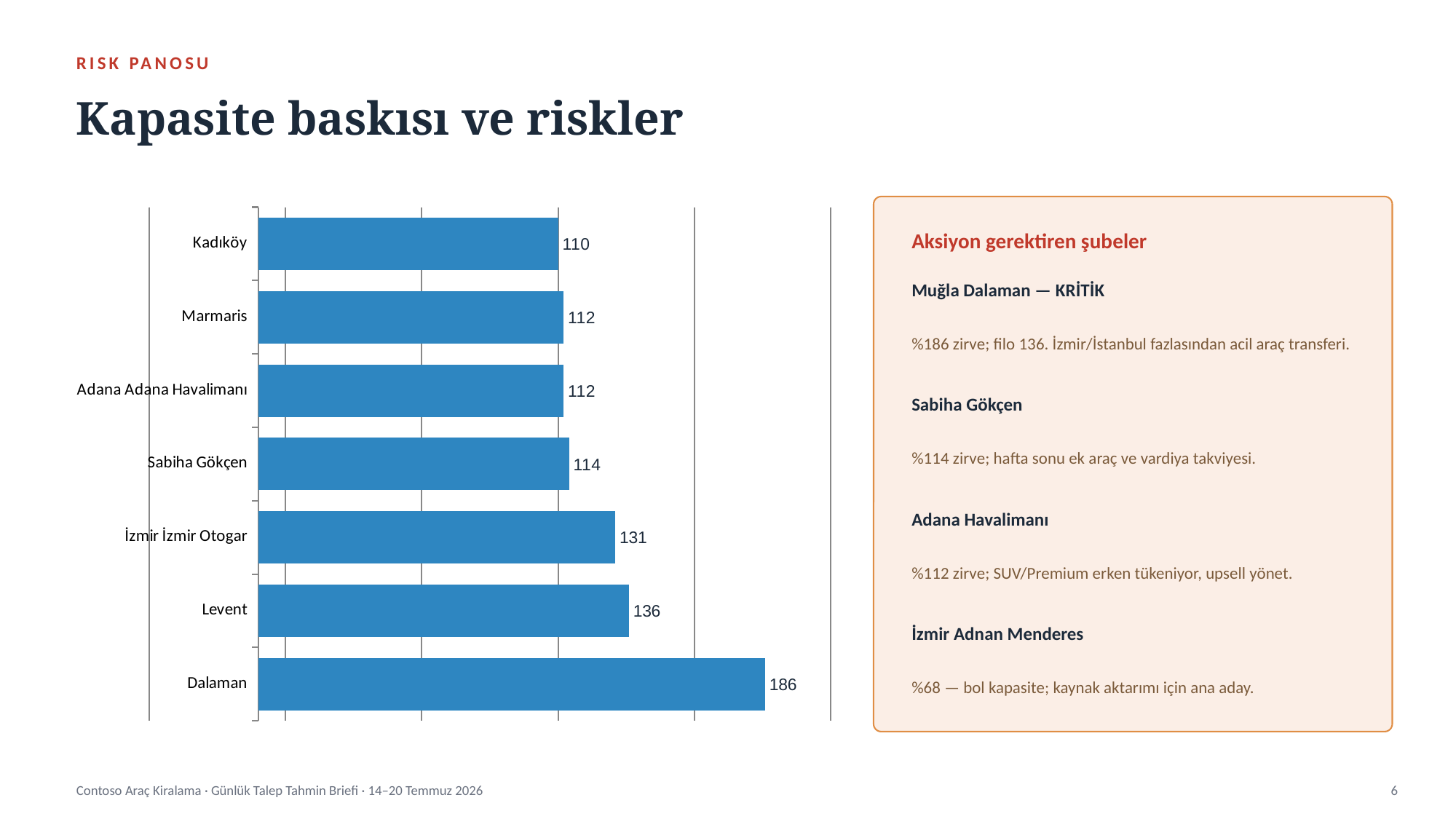
What is the value for Sabiha Gökçen? 114 How many categories are shown in the chart? 7 What kind of chart is shown on the slide? Bar chart What is the value for Dalaman? 186 What is the difference between the values for Dalaman and Levent? 50 What is the value for Levent? 136 Which category has the lowest value? Kadıköy What colour are the bars in the chart? Blue What is the value for Kadıköy? 110 Which category has the highest value? Dalaman Which is larger, the value for Levent or the value for İzmir İzmir Otogar? Levent What is the difference between the values for İzmir İzmir Otogar and Kadıköy? 21